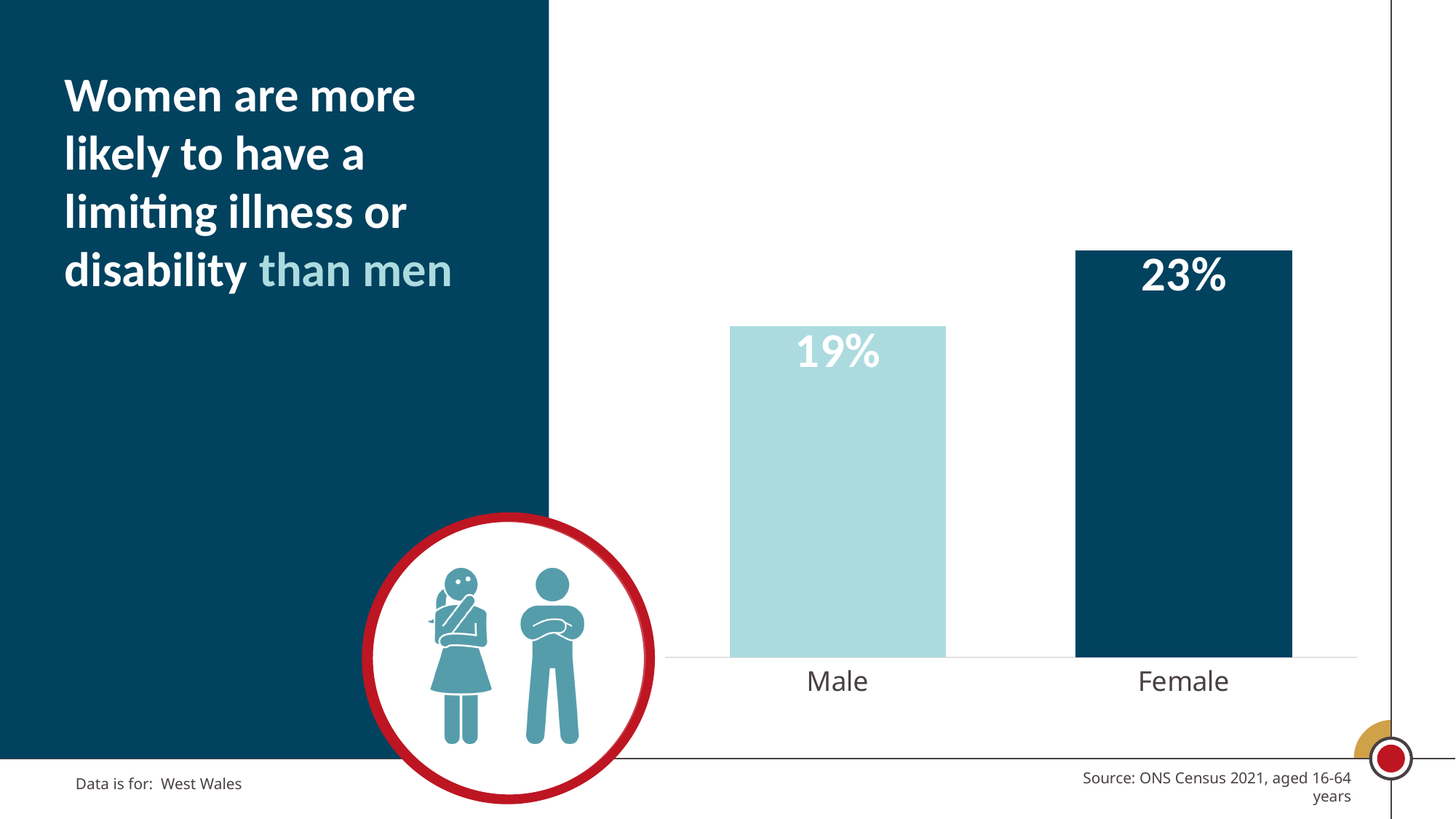
How many categories are shown in the chart? 2 Which category has the lowest value? Male Which is larger, the value for Male or the value for Female? Female Do the values rise or fall from Male to Female? Rise What is the value for Male? 19% What kind of chart is shown on the slide? Bar chart Which category has the highest value? Female What is the source of the data shown in the chart? ONS Census 2021, aged 16-64 years Which area is the chart's data for? West Wales What is the value for Female? 23% What is the difference between the Female and Male values? 4%